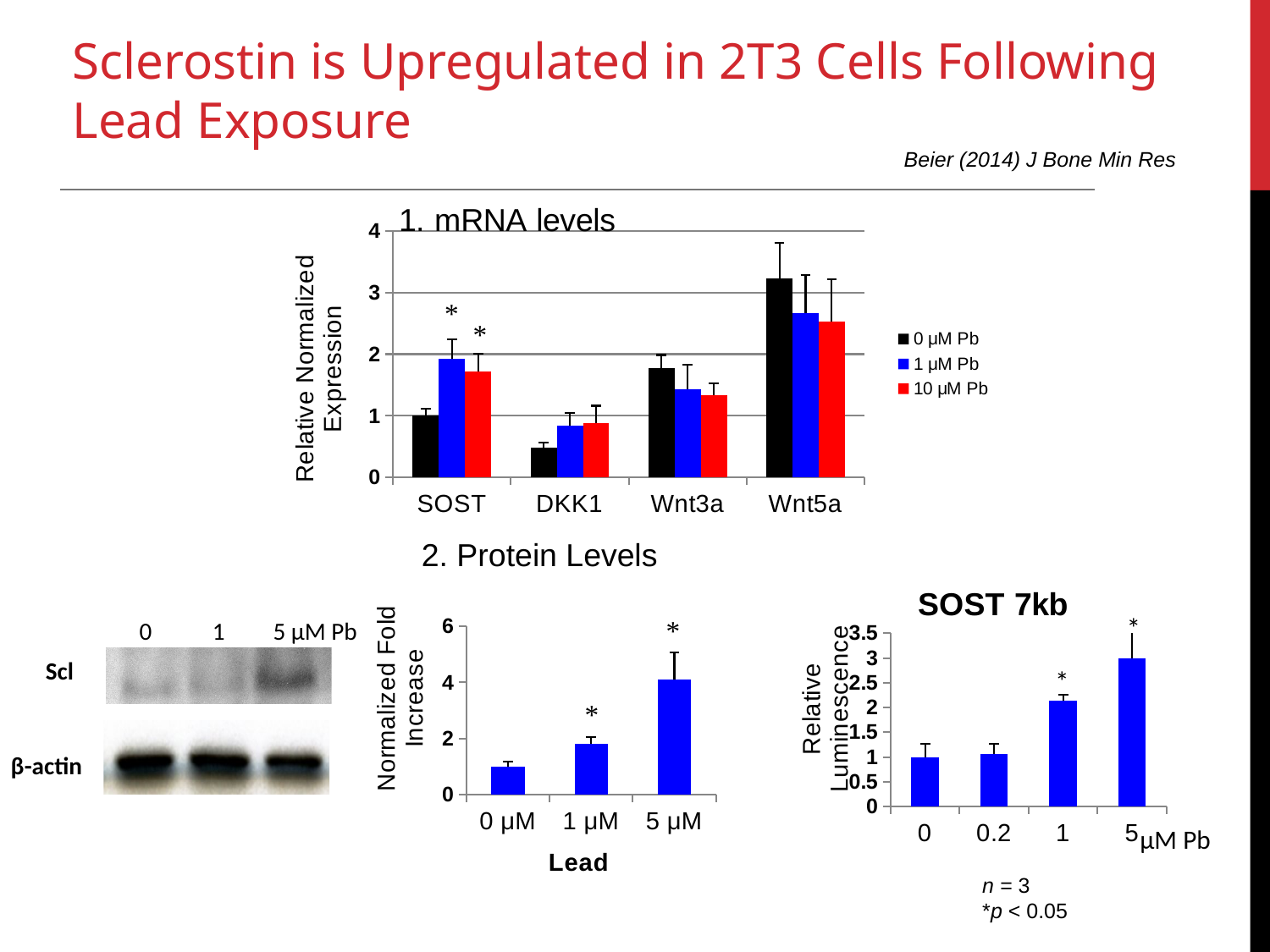
In the "1. mRNA levels" chart, how many gene categories are shown on the x axis? 4 In the "SOST 7kb" chart, is the value for 5 µM Pb greater or less than 2.5? greater In the "1. mRNA levels" chart, is the 0 µM Pb value for Wnt5a greater or less than 3? greater In the middle "Normalized Fold Increase" chart, do the values rise or fall from 0 µM to 5 µM lead? Rise In the "1. mRNA levels" chart, is the 0 µM Pb value for DKK1 greater or less than 1? less In the "1. mRNA levels" chart, which category has the highest 0 µM Pb bar? Wnt5a In the "1. mRNA levels" chart, what colour represents 10 µM Pb in the legend? Red In the "1. mRNA levels" chart, how many series does the legend list? 3 In the "1. mRNA levels" chart, which category has the lowest 0 µM Pb bar? DKK1 What kind of chart is the middle "Normalized Fold Increase" chart under "2. Protein Levels"? Bar chart In the "SOST 7kb" chart, how many lead concentrations are shown on the x axis? 4